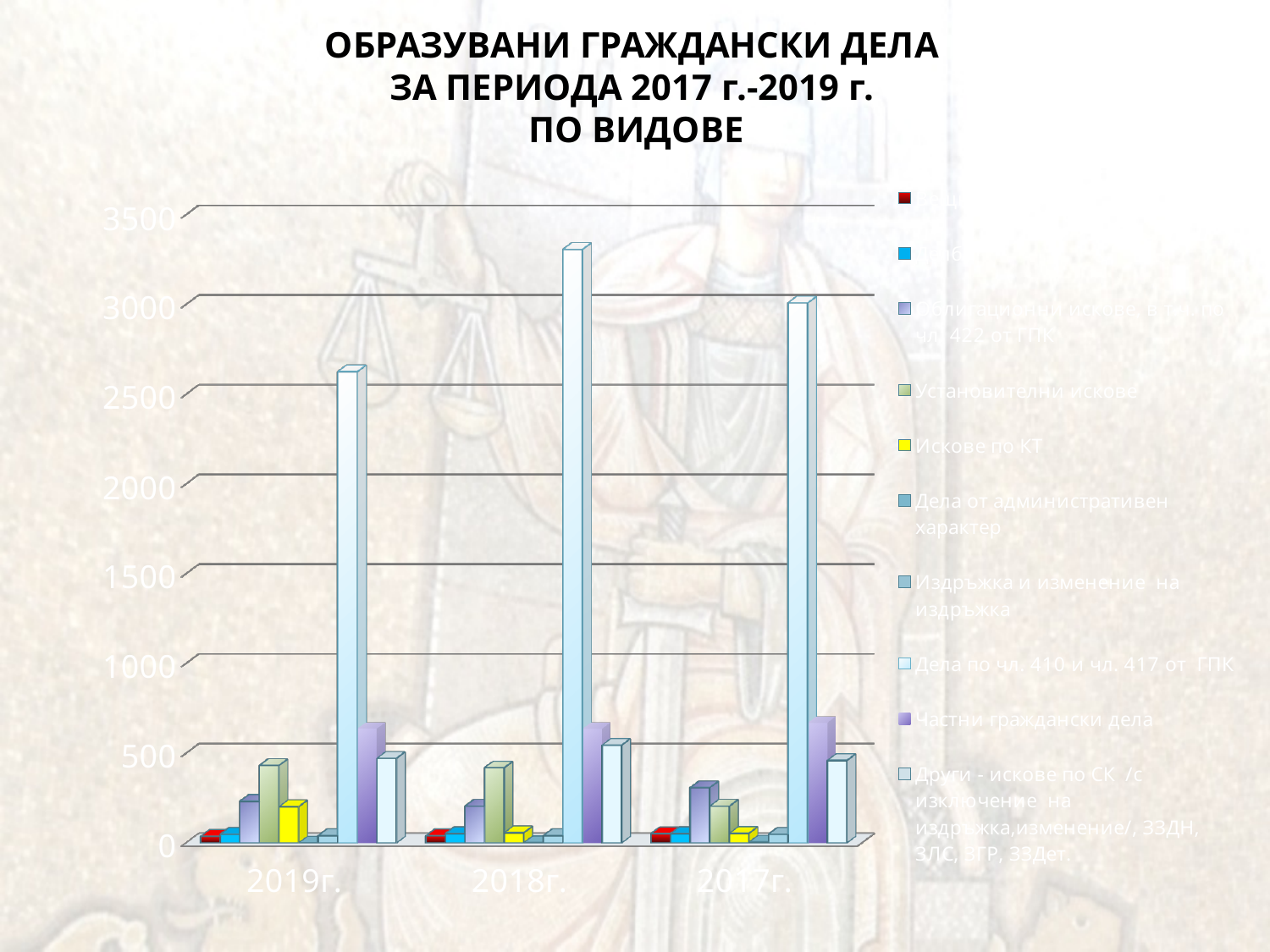
What is the title of the chart? ОБРАЗУВАНИ ГРАЖДАНСКИ ДЕЛА ЗА ПЕРИОДА 2017 г.-2019 г. ПО ВИДОВЕ Is the value for 'Дела по чл. 410 и чл. 417 от ГПК' in 2019г. greater or less than 3000? less Which is larger: 'Дела по чл. 410 и чл. 417 от ГПК' in 2019г. or in 2018г.? 2018г. Is the value for 'Установителни искове' in 2019г. greater or less than 500? less What kind of chart is shown on the slide? bar chart How many series does the legend list? 10 Is the value for 'Искове по КТ' in 2019г. greater or less than 500? less In which year is the bar for 'Установителни искове' the lowest? 2017г. How many year categories are shown on the x axis? 3 In which year is the bar for 'Дела по чл. 410 и чл. 417 от ГПК' the highest? 2018г.